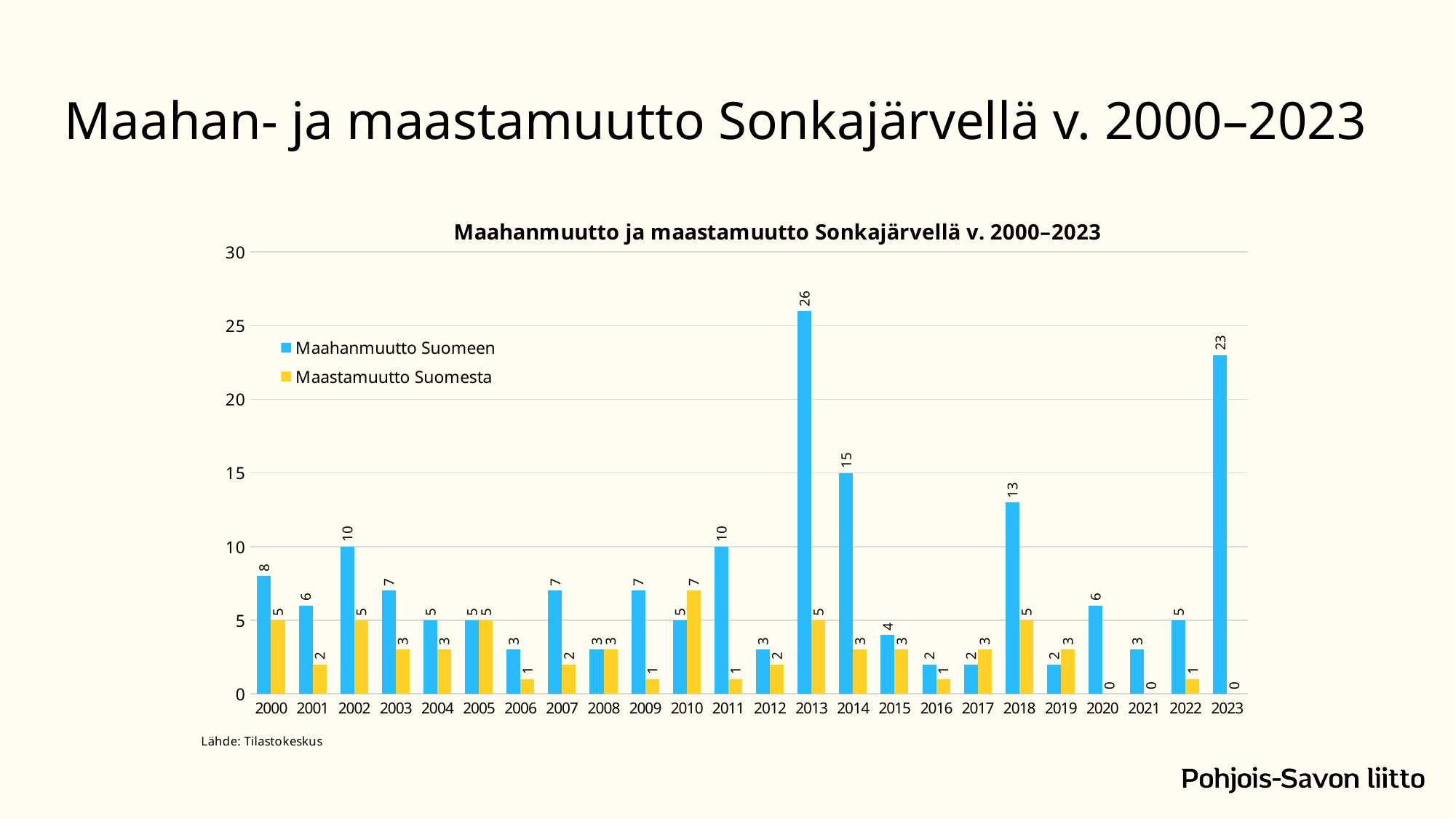
Is the value of Maahanmuutto Suomeen in 2014 greater or less than 10? greater In which year is Maastamuutto Suomesta highest? 2010 What is the value of Maahanmuutto Suomeen in 2023? 23 What is the title of the chart? Maahanmuutto ja maastamuutto Sonkajärvellä v. 2000–2023 What is the value of Maahanmuutto Suomeen in 2013? 26 What is the difference between Maahanmuutto Suomeen and Maastamuutto Suomesta in 2018? 8 What kind of chart is shown on the slide? bar chart Which is larger in 2010, Maahanmuutto Suomeen or Maastamuutto Suomesta? Maastamuutto Suomesta In which year is Maahanmuutto Suomeen highest? 2013 How many years are shown on the x axis? 24 What is the value of Maastamuutto Suomesta in 2010? 7 How many series does the legend list? 2